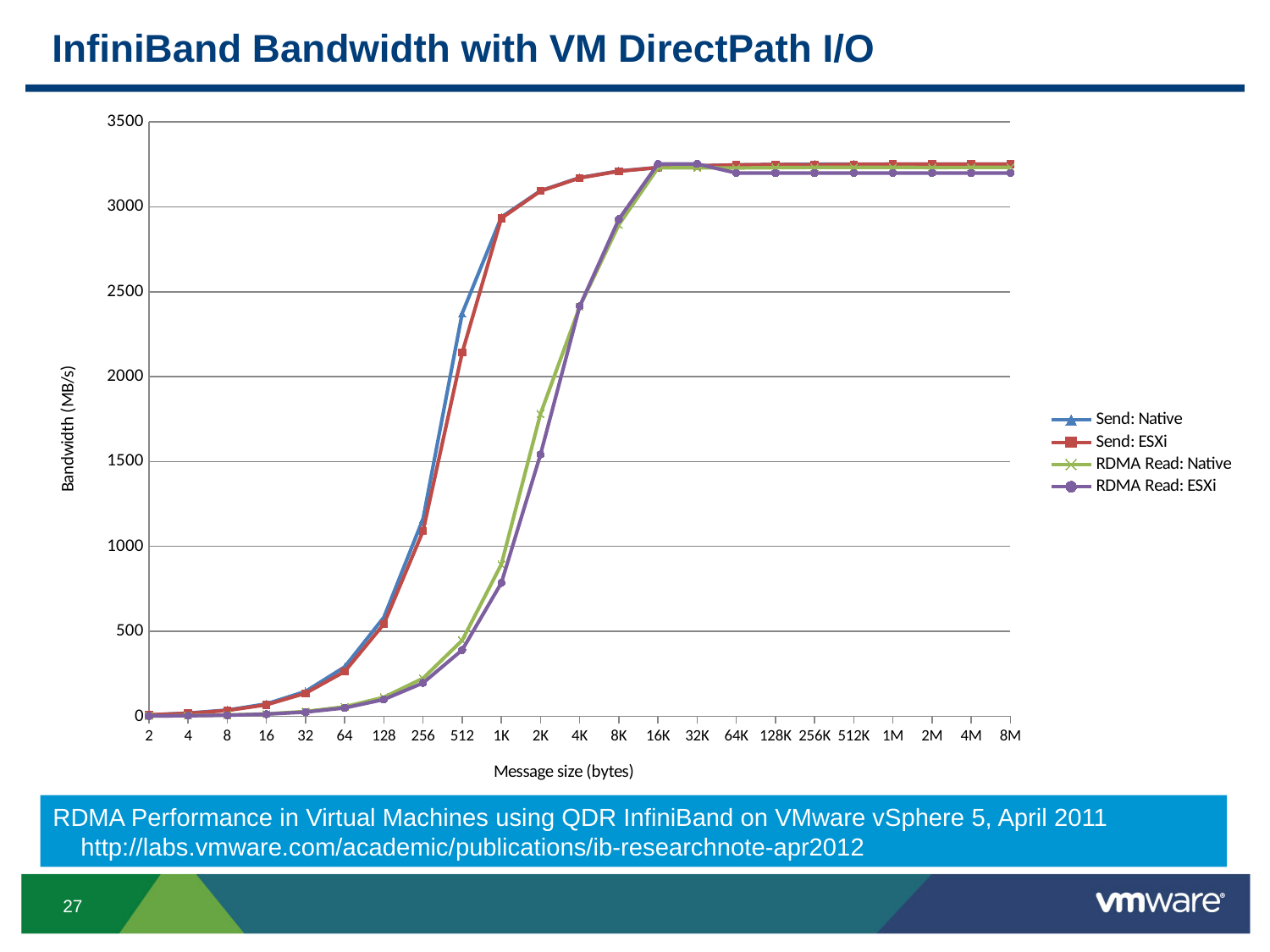
What is the title of the chart? InfiniBand Bandwidth with VM DirectPath I/O Is the value for Send: ESXi at message size 1K greater or less than 2500? greater What kind of chart is shown on the slide? line chart Is the value for Send: ESXi at message size 256 greater or less than 1000? greater What is the label of the y axis? Bandwidth (MB/s) How many message sizes are plotted along the x axis? 23 How many series does the legend list? 4 At message size 2K, which is larger: Send: ESXi or RDMA Read: ESXi? Send: ESXi Is the value for RDMA Read: ESXi at message size 1K greater or less than 1000? less Do the bandwidth values generally rise or fall as message size increases along the x axis? rise